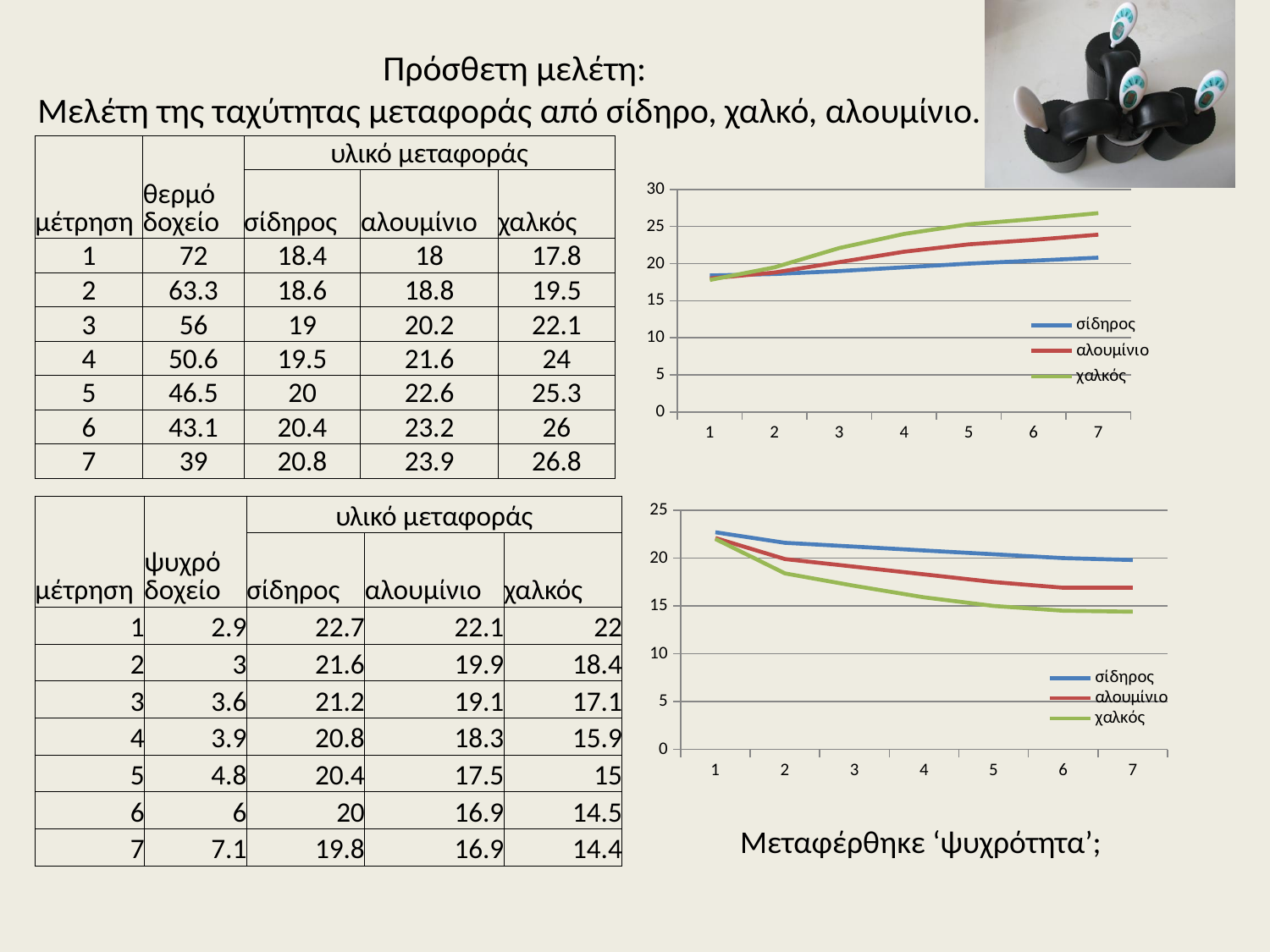
In the bottom chart, which is larger at measurement 4: σίδηρος or χαλκός? σίδηρος In the top chart, which series has the highest value at measurement 7? χαλκός In the bottom chart, is the value for χαλκός at measurement 7 greater or less than 15? less In the top chart, do the values rise or fall from measurement 1 to measurement 7? rise In the top chart, which series has the lowest value at measurement 7? σίδηρος What kind of chart is the top chart on the slide? line chart How many series does the legend of the bottom chart list? 3 In the bottom chart, do the values rise or fall from measurement 1 to measurement 7? fall In the top chart, is the value for χαλκός at measurement 7 greater or less than 25? greater What colour is the line for αλουμίνιο in the top chart? red In the bottom chart, which series has the lowest value at measurement 7? χαλκός How many points are plotted along the x axis of the top chart? 7